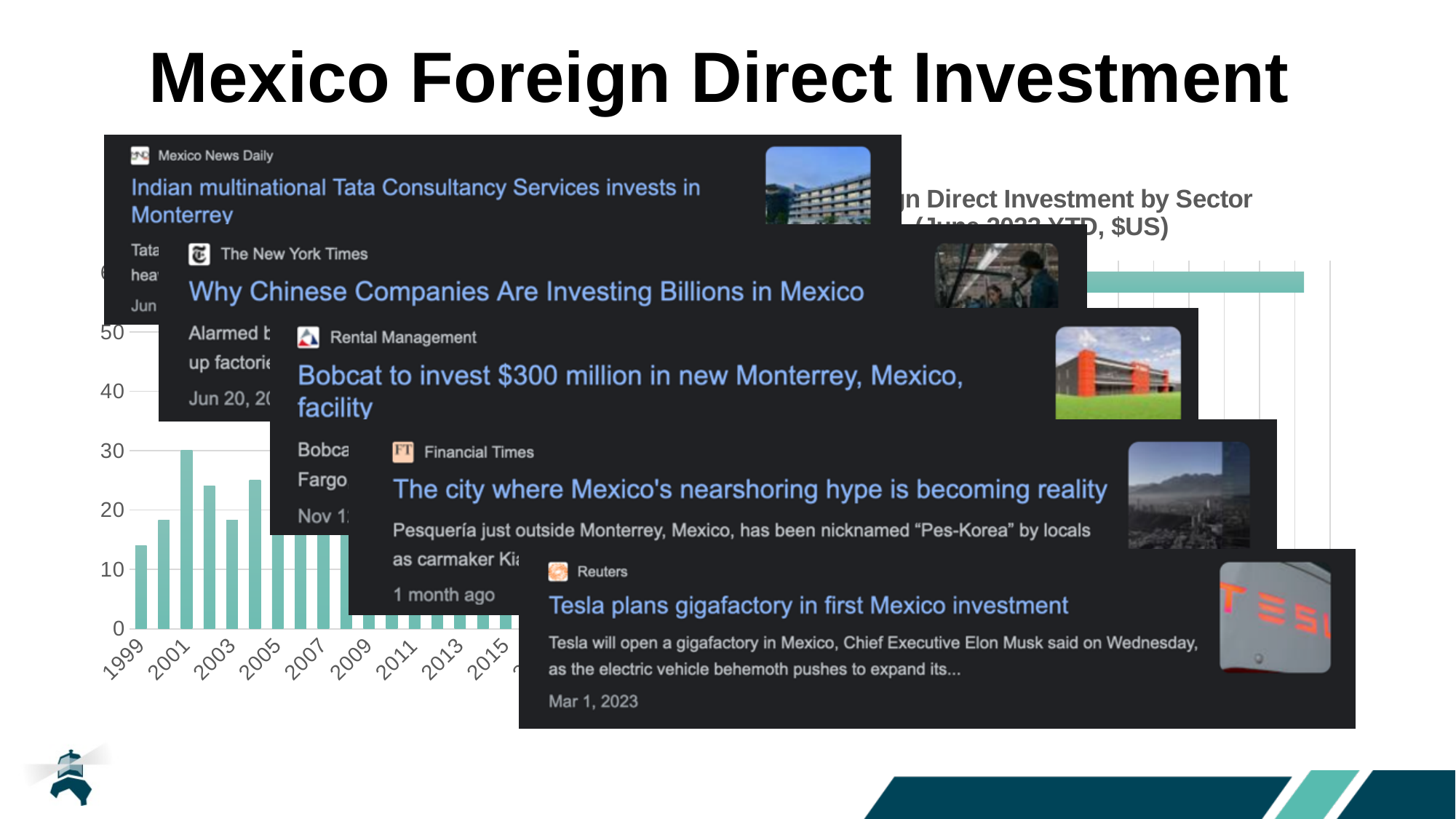
In the bar chart in the lower left, is the value for 1999 greater or less than 10? greater In the bar chart in the lower left, is the value for 2001 greater or less than 20? greater In the bar chart in the lower left, is the value for 2003 greater or less than 20? less In the bar chart in the lower left, which is larger, the value for 2001 or the value for 1999? 2001 In the bar chart in the lower left, what colour are the bars? teal What kind of chart is the chart in the lower left of the slide? bar chart In the bar chart in the lower left, which is larger, the value for 2001 or the value for 2003? 2001 In the bar chart in the lower left, which is larger, the value for 2000 or the value for 1999? 2000 In the bar chart in the lower left, what is the first year shown on the x axis? 1999